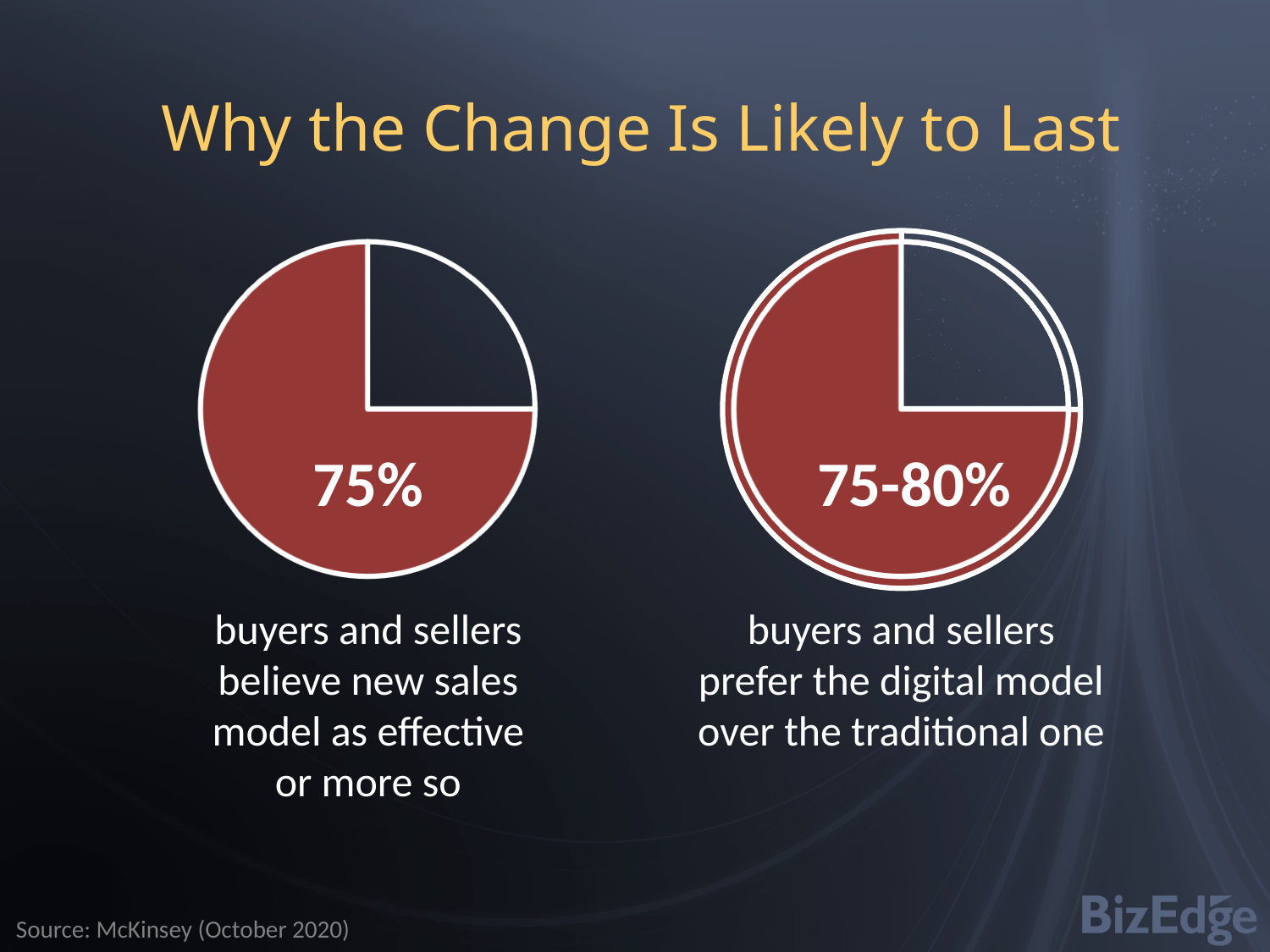
On the right pie chart, what share of buyers and sellers prefer the digital model over the traditional one? 75-80% What value is printed on the right pie chart? 75-80% What kind of chart is used on the right side of the slide? Pie chart How many pie charts are shown on the slide? 2 On the left pie chart, what share of buyers and sellers believe the new sales model is as effective or more so? 75% What source is cited for the data in the pie charts? McKinsey (October 2020) What percentage is shown on the left pie chart? 75% What is the title of the slide containing the two pie charts? Why the Change Is Likely to Last On the left pie chart, is the highlighted slice greater or less than 50%? greater On the right pie chart, is the highlighted slice greater or less than 50%? greater What kind of chart is used on the left side of the slide? Pie chart